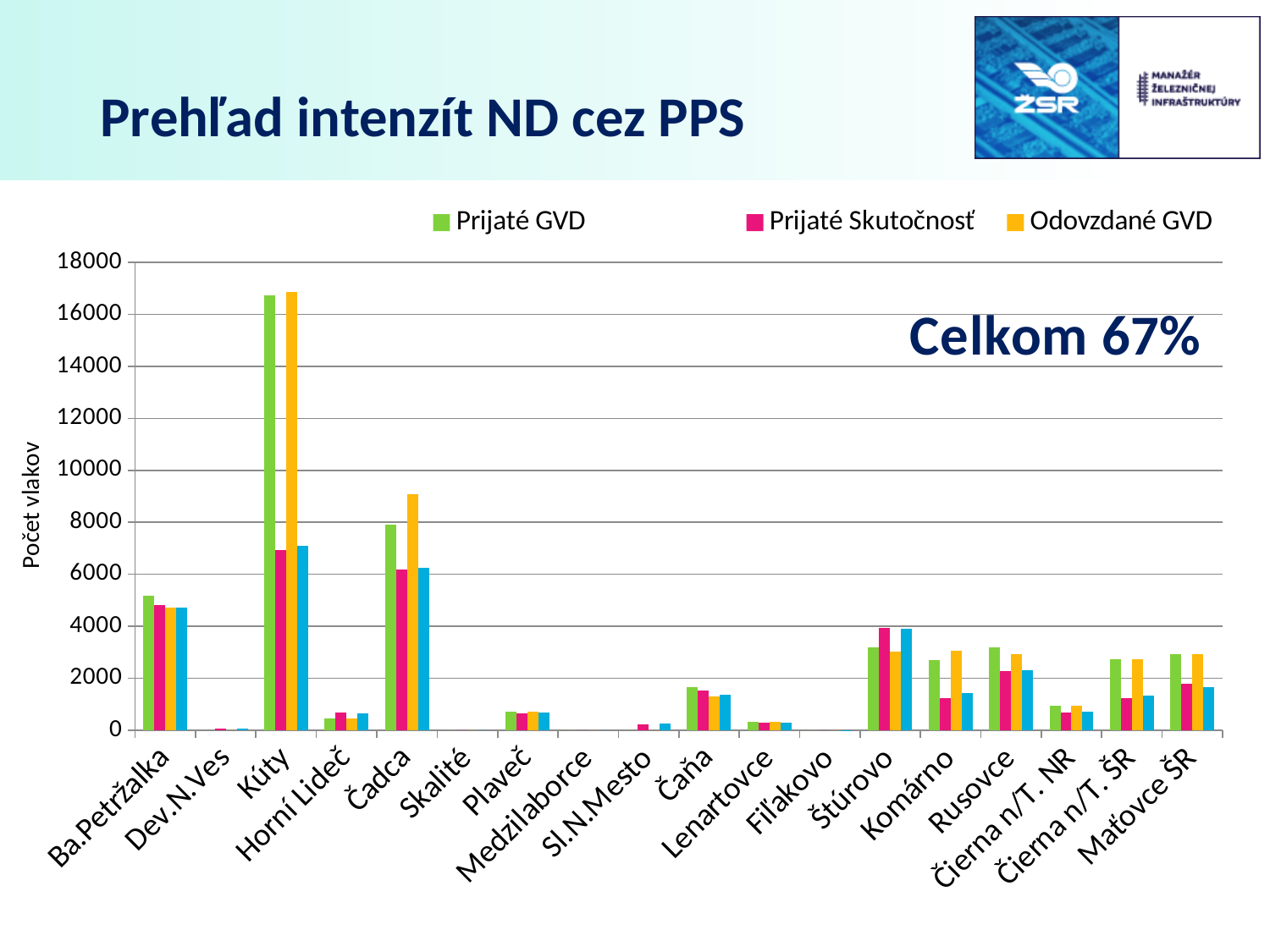
Is the value for Prijaté Skutočnosť at Kúty greater or less than 8000? less Is the value for Odovzdané GVD at Čadca greater or less than 8000? greater Which category has the highest value for Prijaté GVD? Kúty Which is larger at Čadca: Prijaté GVD or Prijaté Skutočnosť? Prijaté GVD How many categories are shown along the x axis of the chart? 18 Is the value for Prijaté GVD at Kúty greater or less than 16000? greater Which is larger at Komárno: Prijaté GVD or Prijaté Skutočnosť? Prijaté GVD What is the label of the y axis of the chart? Počet vlakov How many series does the chart legend list? 3 What kind of chart is shown on the slide? bar chart Which category has the highest value for Odovzdané GVD? Kúty